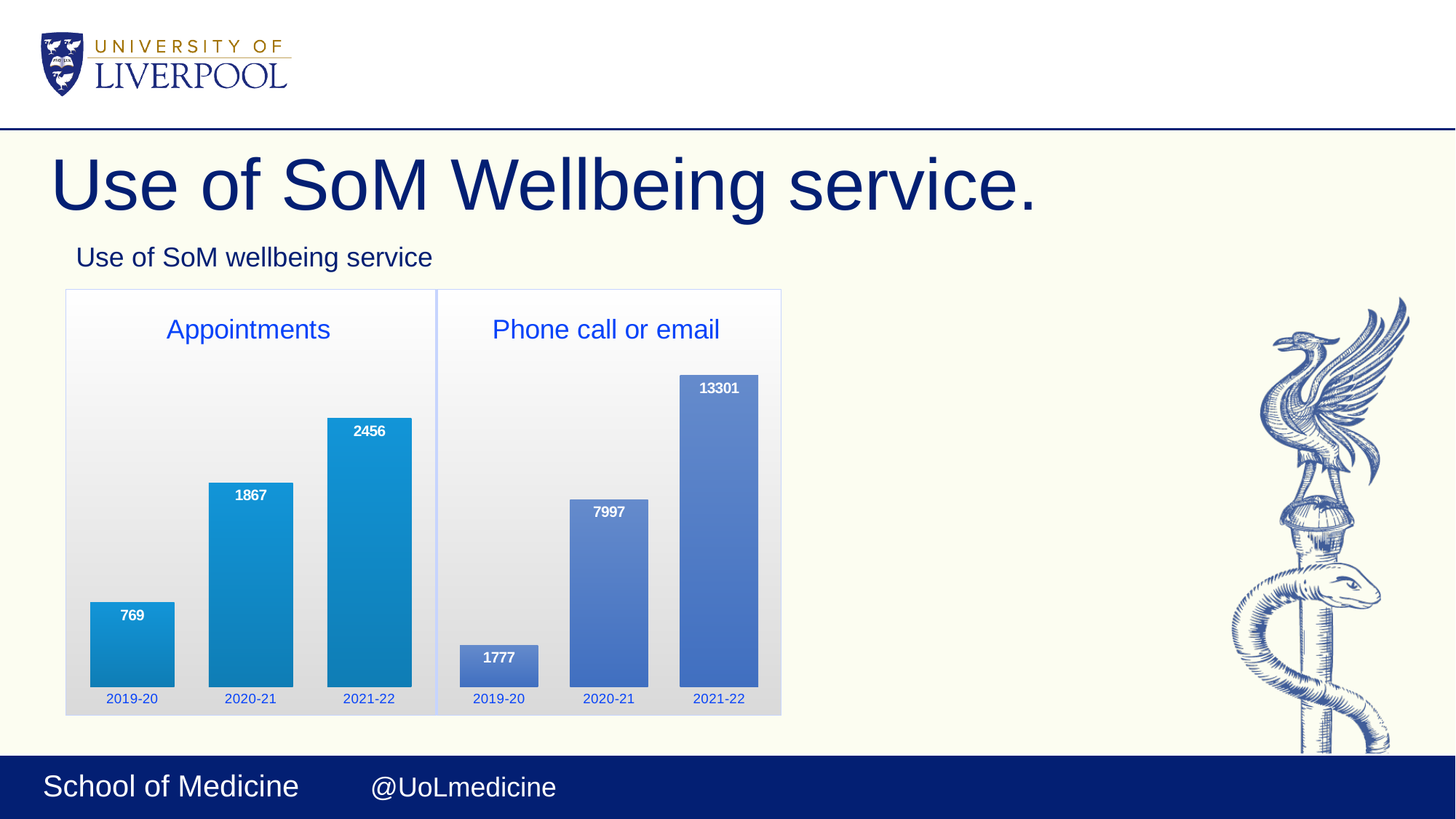
How many years are shown in the Appointments panel? 3 What is the difference between Appointments in 2021-22 and 2020-21? 589 What is the title of the chart? Use of SoM wellbeing service Which is larger: Appointments in 2021-22 or Phone call or email in 2019-20? Appointments in 2021-22 Which year has the highest number of Appointments? 2021-22 What is the value for Phone call or email in 2021-22? 13301 Which year has the lowest value for Phone call or email? 2019-20 What kind of chart is shown on the slide? Bar chart What is the number of Appointments in 2019-20? 769 Do the Phone call or email values rise or fall from 2019-20 to 2021-22? Rise What is the difference between Phone call or email in 2021-22 and 2019-20? 11524 What is the value for Phone call or email in 2020-21? 7997